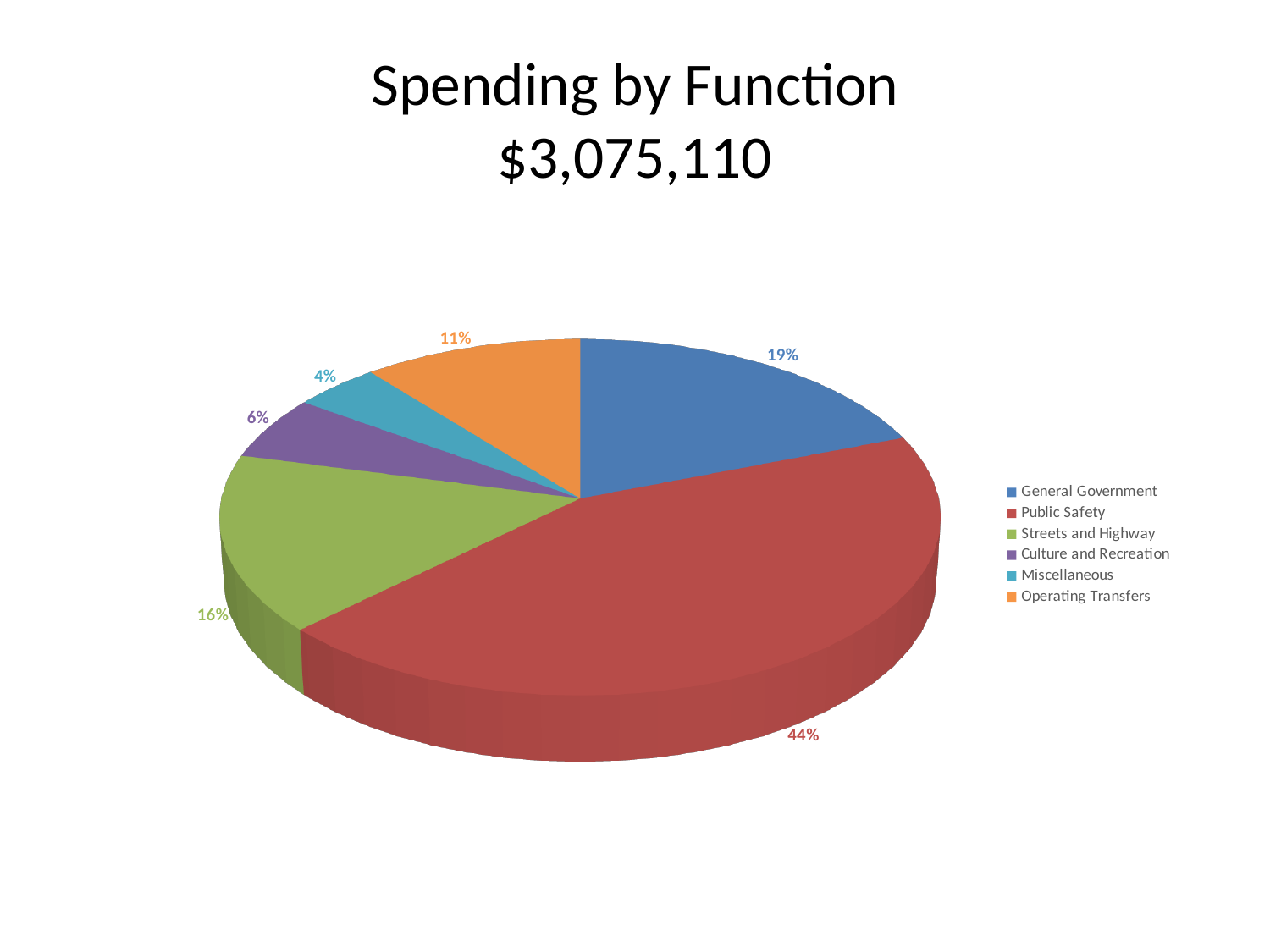
What share of spending goes to Operating Transfers? 11% Which function has the smallest share of spending? Miscellaneous How many functions are shown in the pie chart? 6 What share of spending goes to Streets and Highway? 16% Which function has the largest share of spending? Public Safety What kind of chart is shown on the slide? Pie chart What share of spending goes to Public Safety? 44% What share of spending goes to Miscellaneous? 4% What is the difference in percentage points between Public Safety and General Government? 25 What total spending amount is shown in the chart title? $3,075,110 What share of spending goes to General Government? 19% Which has a larger share, Culture and Recreation or Operating Transfers? Operating Transfers